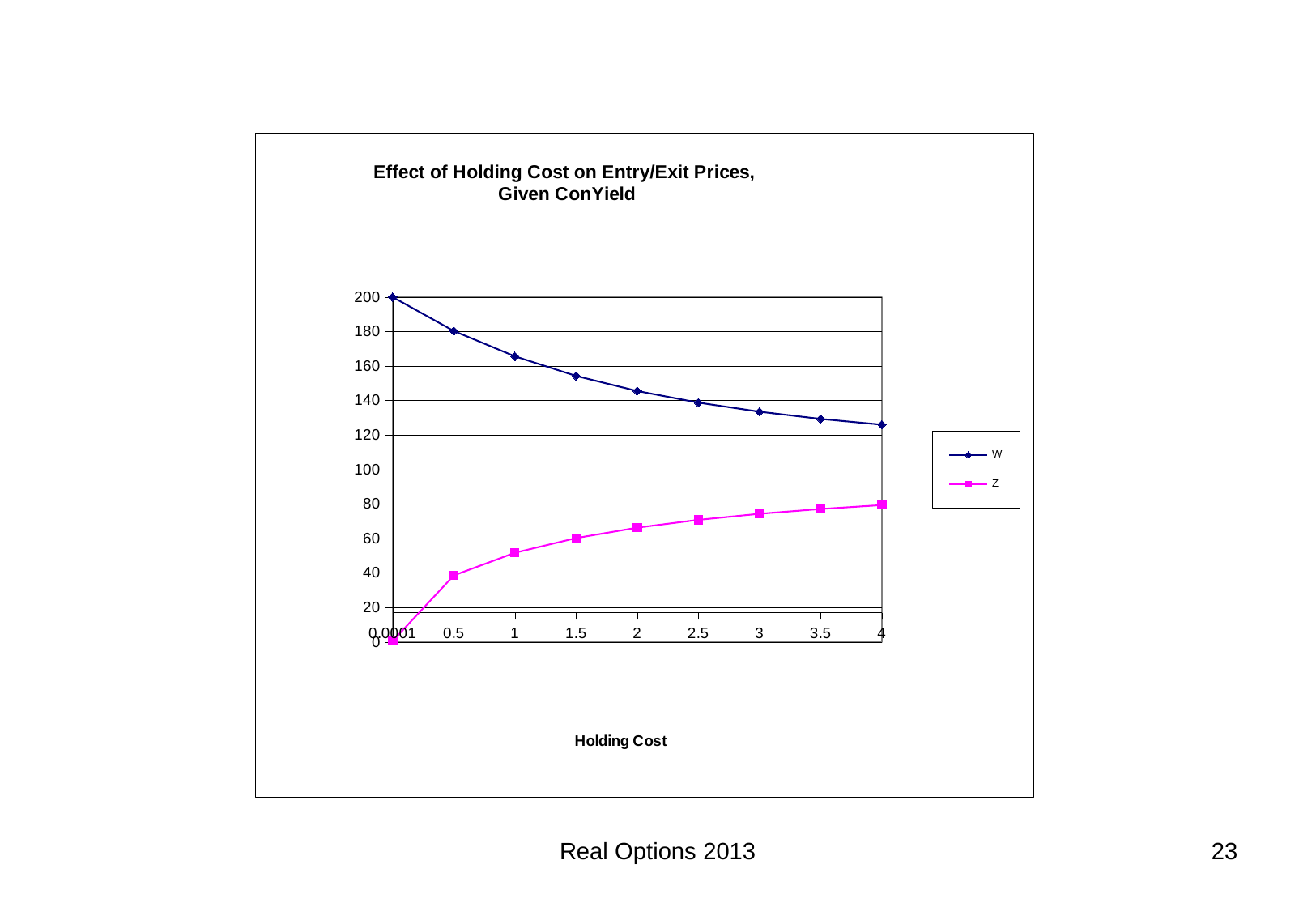
Is the value of Z at a holding cost of 1 greater or less than 60? less How many holding cost values are plotted along the x axis? 9 What is the label of the x axis? Holding Cost Is the value of W at a holding cost of 4 greater or less than 140? less Which series has the larger value at a holding cost of 2, W or Z? W Does the W series rise or fall as holding cost increases? fall What is the value of W at a holding cost of 0.0001? 200 What is the value of Z at a holding cost of 0.0001? 0 At which holding cost is the W series highest? 0.0001 What kind of chart is shown on the slide? line chart Does the Z series rise or fall as holding cost increases? rise How many series does the legend list? 2